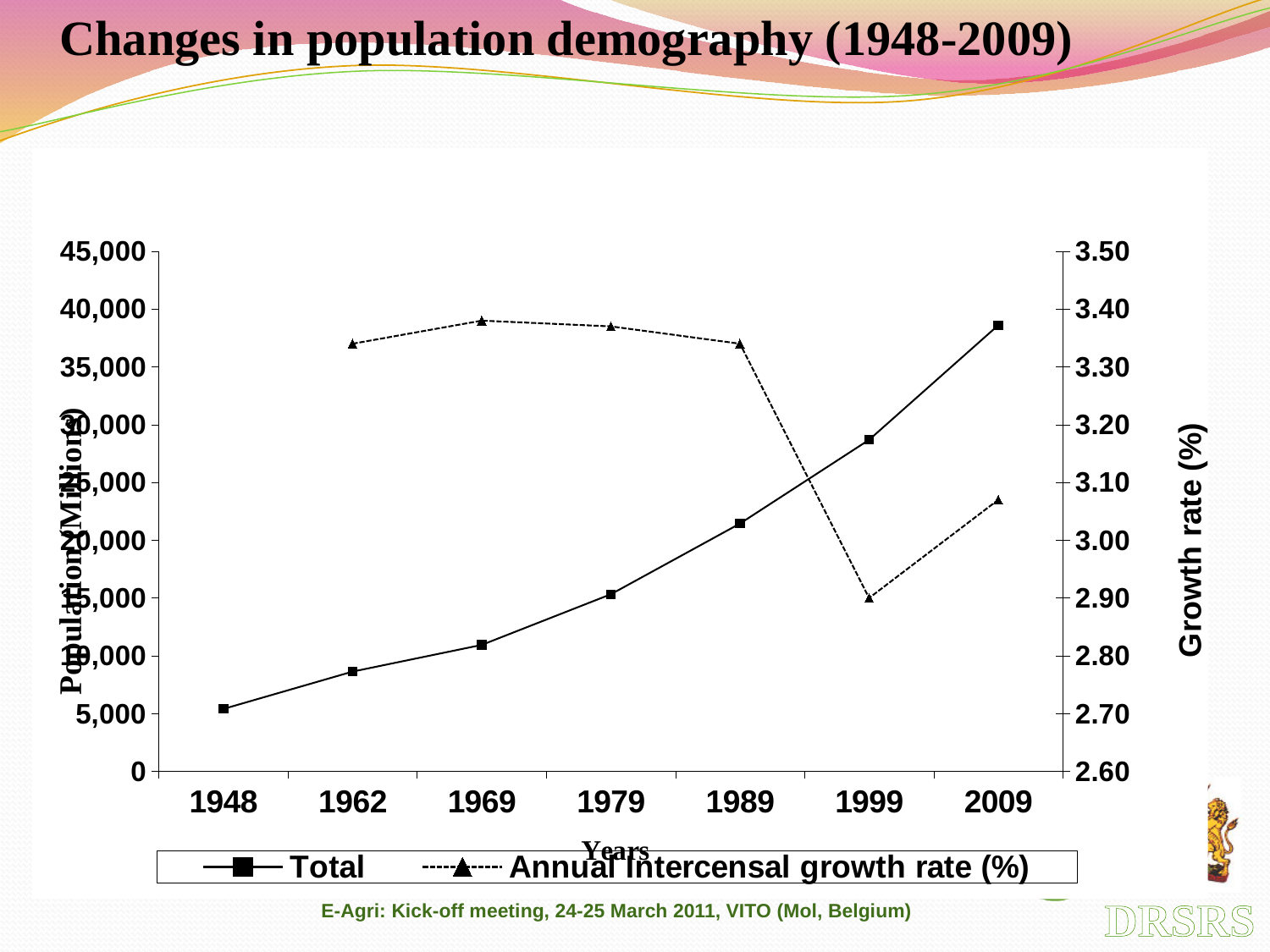
How many years are shown on the x axis? 7 What kind of chart is shown on the slide? line chart Is the Total population in 1948 greater or less than 10,000? less Which is larger, the Annual Intercensal growth rate (%) in 1989 or in 2009? 1989 In which year is the Total population lowest? 1948 In which year is the Total population highest? 2009 Does the Total population rise or fall from 1948 to 2009? rise Is the Total population in 2009 greater or less than 35,000? greater What is the title of the chart? Changes in population demography (1948-2009) How many series does the legend list? 2 In which year is the Annual Intercensal growth rate (%) lowest? 1999 Is the Annual Intercensal growth rate (%) in 1999 greater or less than 3.00? less